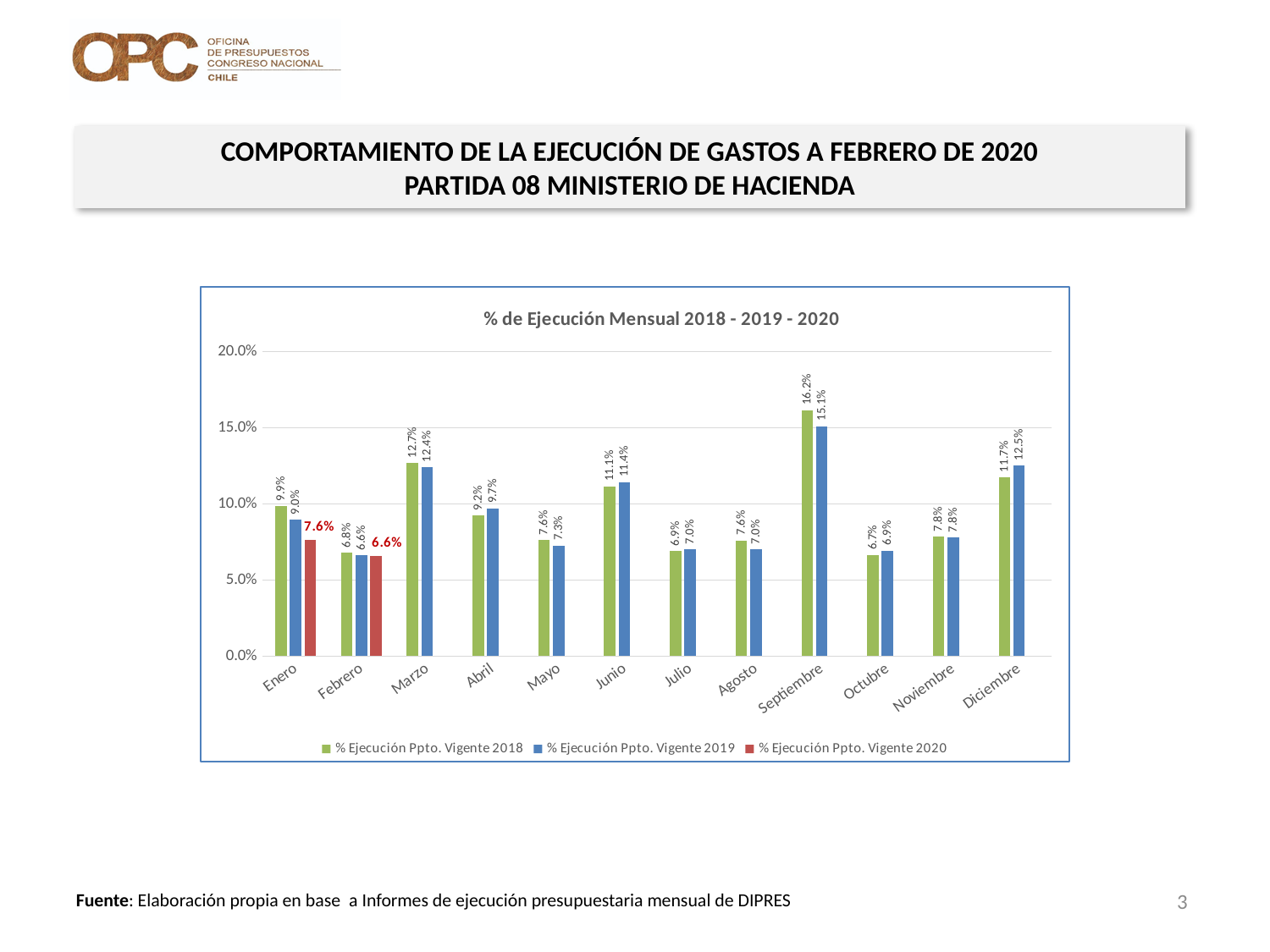
What is the value for Diciembre in the % Ejecución Ppto. Vigente 2019 series? 12.5% What kind of chart is shown on the slide? Bar chart What is the title of the chart? % de Ejecución Mensual 2018 - 2019 - 2020 Which month has the lowest value in the % Ejecución Ppto. Vigente 2018 series? Octubre What is the value for Septiembre in the % Ejecución Ppto. Vigente 2018 series? 16.2% Which is larger for Marzo: the 2018 value or the 2019 value? 2018 value (12.7%) What is the difference between the 2018 and 2019 values for Septiembre? 1.1% Which month has the highest value in the % Ejecución Ppto. Vigente 2019 series? Septiembre How many series does the legend list? 3 How many months are shown on the x axis? 12 Is the value for Junio in the 2019 series greater or less than 10.0%? greater What is the value for Enero in the % Ejecución Ppto. Vigente 2020 series? 7.6%